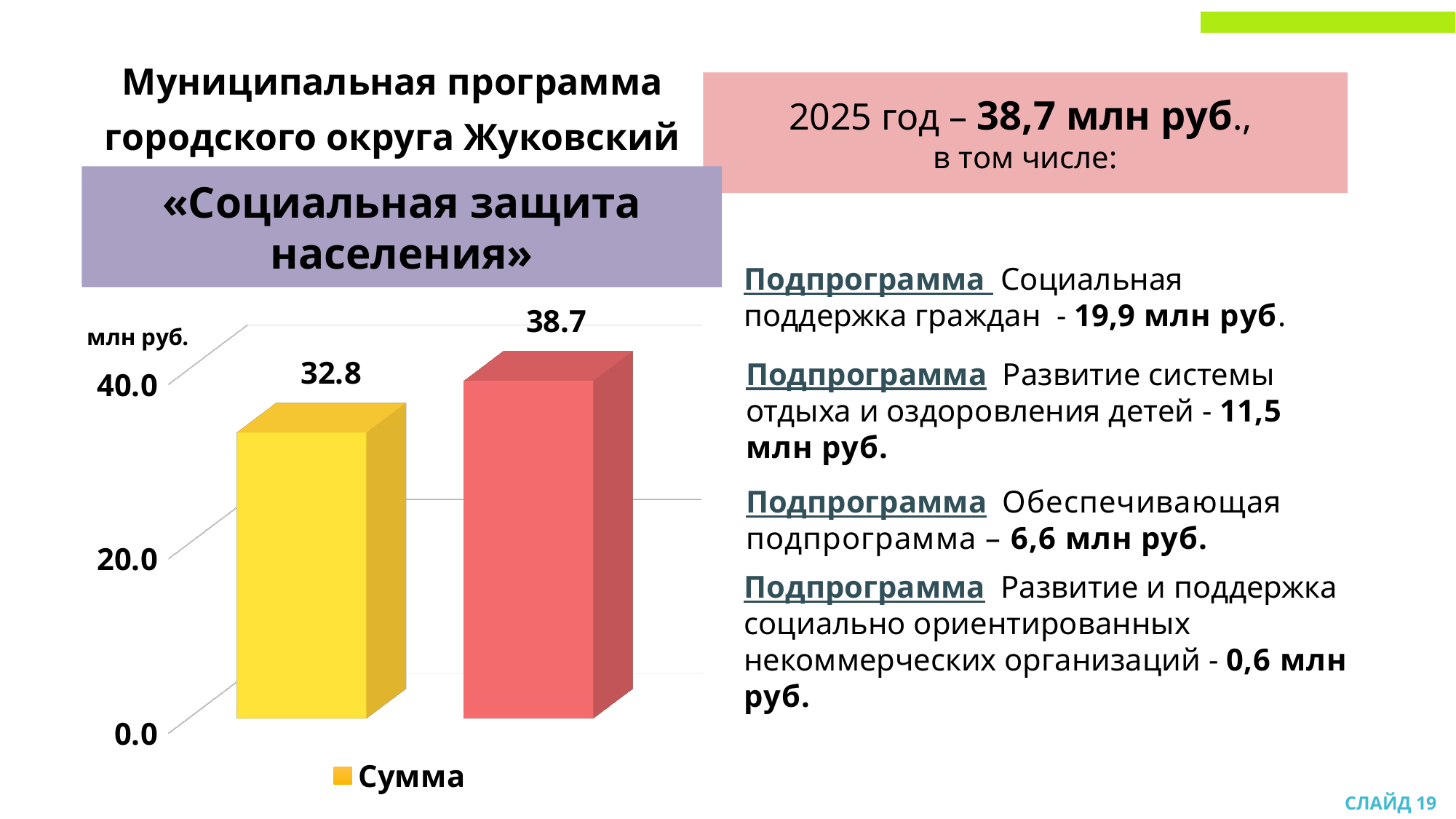
What is the name of the series shown in the chart legend? Сумма How many bars are plotted in the chart? 2 Which is larger, the value of the yellow bar or the value of the red bar? The red bar How many series does the chart legend list? 1 Which bar in the chart has the highest value? The red (right) bar Is the value of the yellow bar greater or less than 40.0? less What kind of chart is shown on the slide? Bar chart What is the difference between the red bar (38.7) and the yellow bar (32.8)? 5.9 What value is shown on the yellow (left) bar of the chart? 32.8 What value is shown on the red (right) bar of the chart? 38.7 Is the value of the red bar greater or less than 20.0? greater Which bar in the chart has the lowest value? The yellow (left) bar